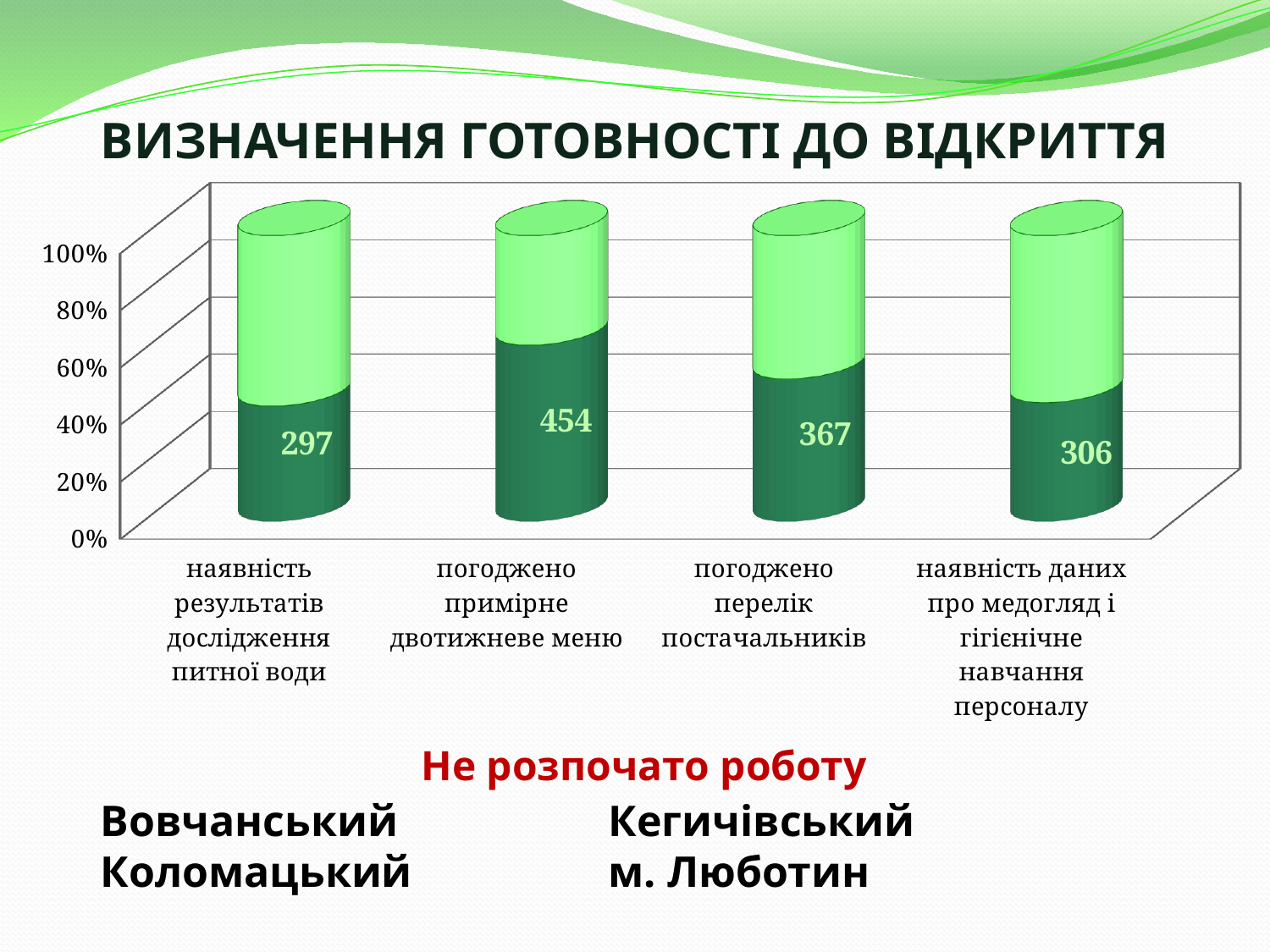
What kind of chart is shown on the slide? Stacked bar chart What is the data label on the bar for "наявність даних про медогляд і гігієнічне навчання персоналу"? 306 What is the data label on the bar for "наявність результатів дослідження питної води"? 297 What is the title of the slide above the chart? ВИЗНАЧЕННЯ ГОТОВНОСТІ ДО ВІДКРИТТЯ Which category has the lowest labelled value? наявність результатів дослідження питної води What is the data label on the bar for "погоджено примірне двотижневе меню"? 454 How many categories are shown on the chart? 4 What is the data label on the bar for "погоджено перелік постачальників"? 367 Which has the larger labelled value: "погоджено перелік постачальників" or "наявність даних про медогляд і гігієнічне навчання персоналу"? погоджено перелік постачальників Which category has the highest labelled value? погоджено примірне двотижневе меню What is the difference between the labelled values for "погоджено перелік постачальників" and "наявність даних про медогляд і гігієнічне навчання персоналу"? 61 What is the difference between the labelled values for "погоджено примірне двотижневе меню" and "наявність результатів дослідження питної води"? 157